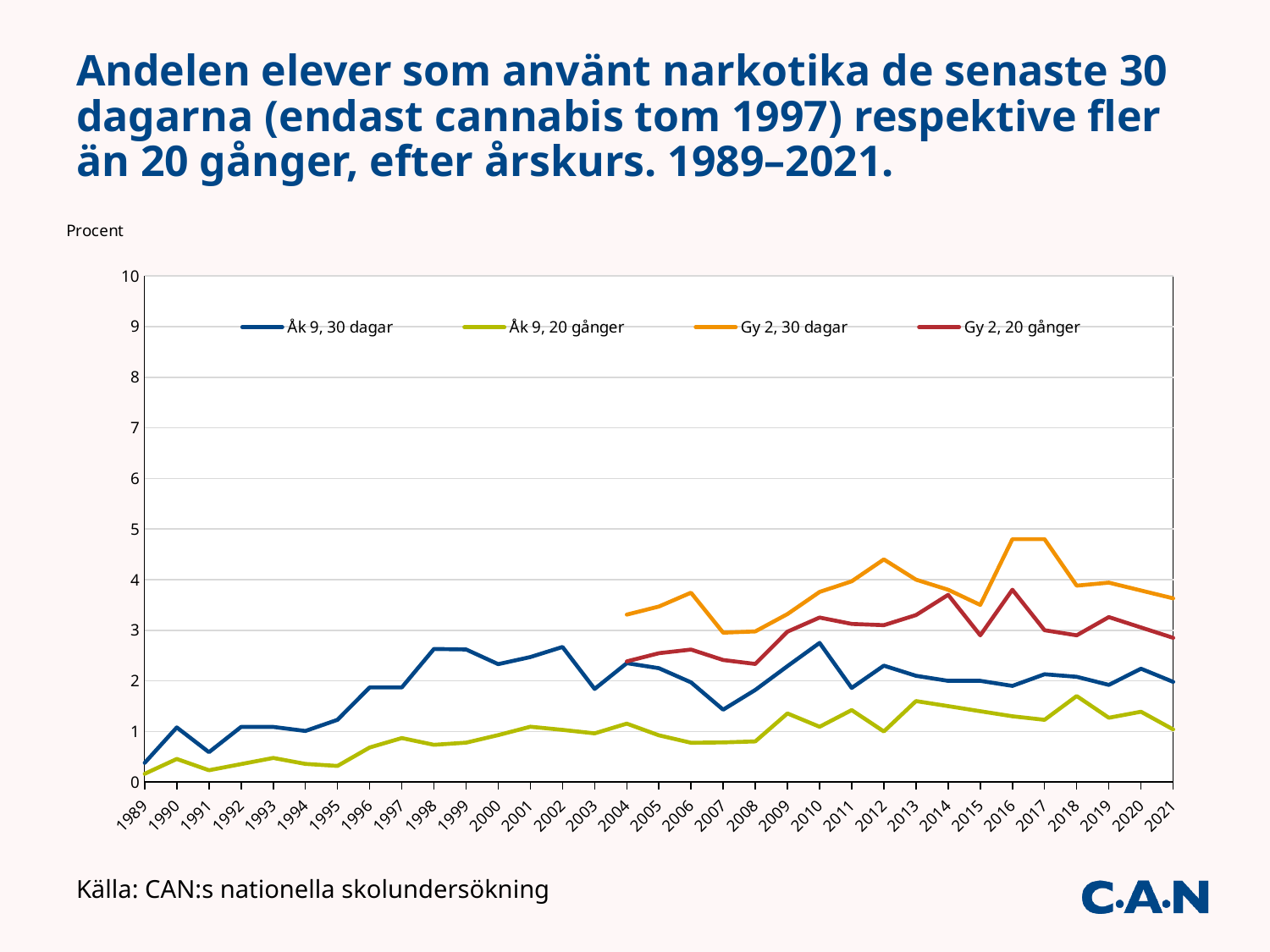
What kind of chart is shown on the slide? Line chart Is the value for Åk 9, 30 dagar in 1989 greater or less than 1? less In 2021, which is larger: Gy 2, 20 gånger or Åk 9, 30 dagar? Gy 2, 20 gånger Which series has the lowest value on the chart, and in which year? Åk 9, 20 gånger, 1989 Is the value for Åk 9, 30 dagar in 2007 greater or less than 2? less What is the label on the y axis? Procent Which series reaches the highest value anywhere on the chart? Gy 2, 30 dagar Does the Åk 9, 30 dagar line rise or fall between 1989 and 1998? rise How many series does the legend list? 4 How many years are labelled along the x axis? 33 Is the value for Gy 2, 30 dagar in 2016 greater or less than 4? greater